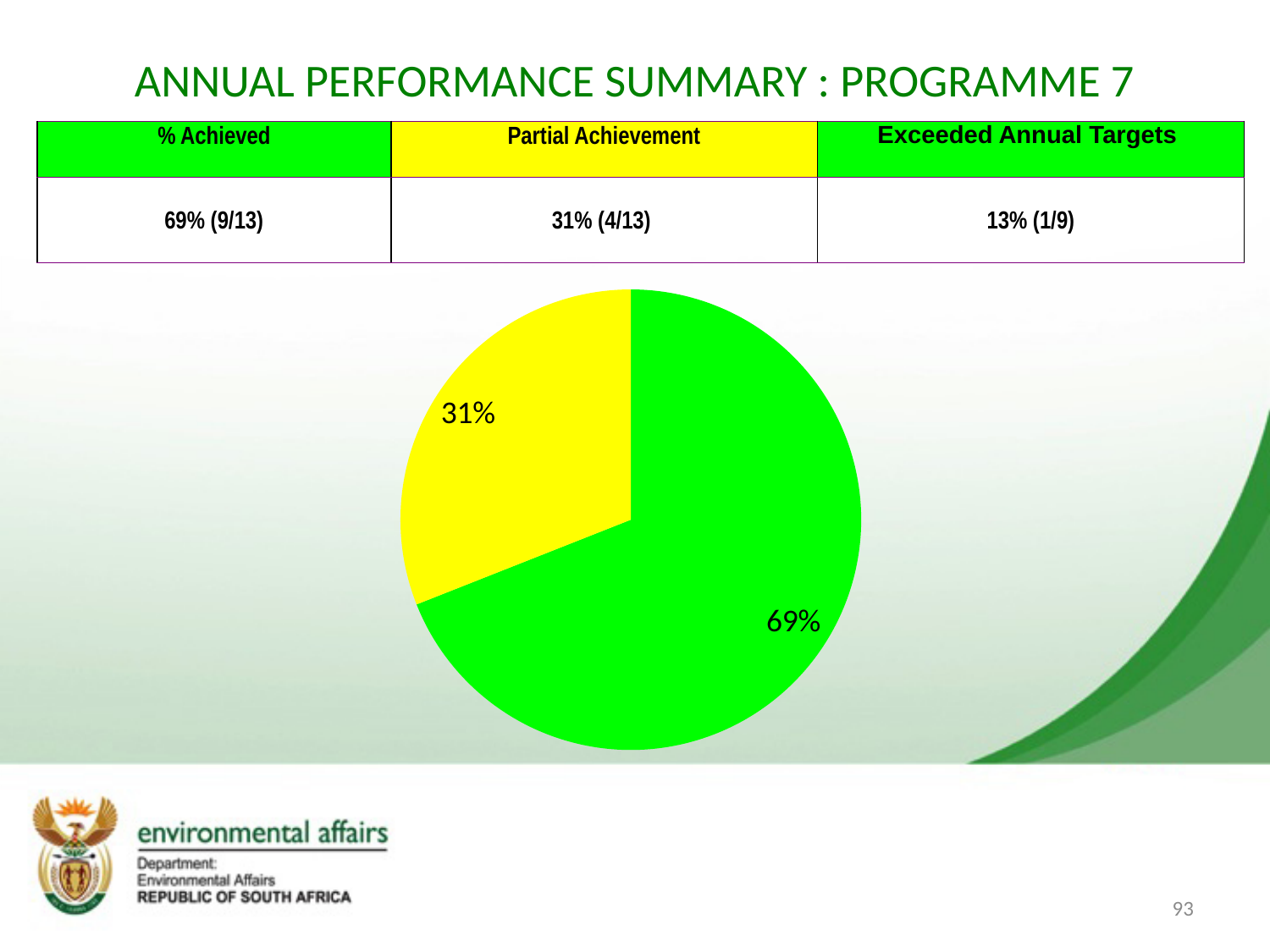
Is the value of the green slice of the pie chart greater or less than 50%? greater What is the difference in percentage points between the green slice and the yellow slice of the pie chart? 38 percentage points What value is labelled on the green slice of the pie chart? 69% What colour is the slice of the pie chart labelled 69%? green How many slices does the pie chart have? 2 What value is labelled on the yellow slice of the pie chart? 31% Which slice of the pie chart is the smallest? the yellow slice (31%) What share of the pie does the yellow slice represent? 31% Which slice of the pie chart is the largest? the green slice (69%) What is the title of the slide containing the pie chart? ANNUAL PERFORMANCE SUMMARY : PROGRAMME 7 Which is larger in the pie chart, the green slice or the yellow slice? the green slice What kind of chart is shown on the slide? pie chart